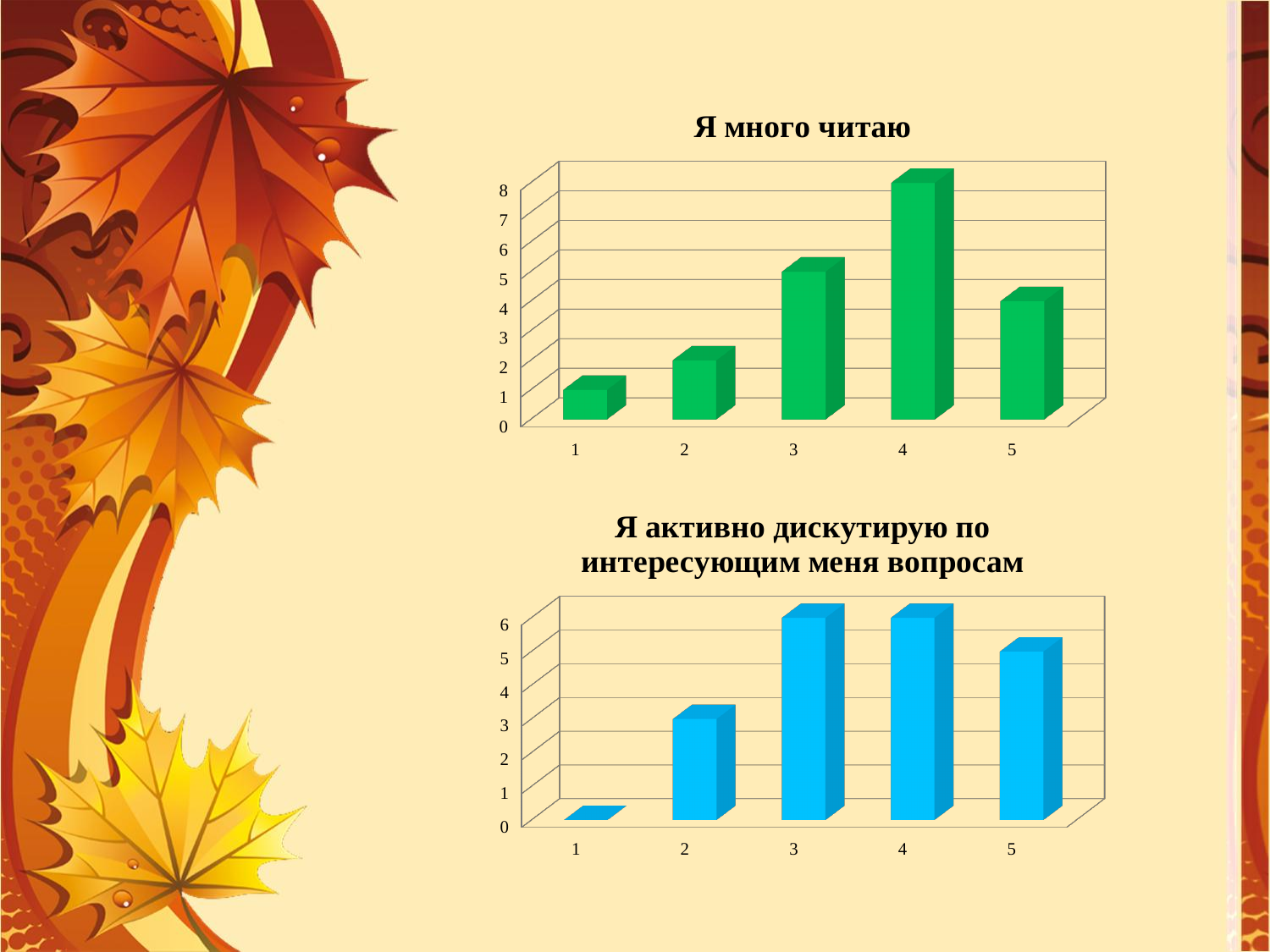
In the chart titled "Я много читаю", is the value for category 3 greater or less than 4? greater In the chart titled "Я много читаю", which is larger, the value for category 3 or the value for category 5? category 3 In the chart titled "Я много читаю", how many categories are shown on the x axis? 5 In the chart titled "Я активно дискутирую по интересующим меня вопросам", which is larger, the value for category 2 or the value for category 5? category 5 What colour are the bars in the bottom chart on the slide? blue In the chart titled "Я активно дискутирую по интересующим меня вопросам", what is the highest value shown on the vertical axis? 6 In the chart titled "Я много читаю", which category has the lowest value? 1 What kind of chart is the top chart on the slide? bar chart In the chart titled "Я активно дискутирую по интересующим меня вопросам", is the value for category 2 greater or less than 4? less In the chart titled "Я много читаю", which category has the highest value? 4 In the chart titled "Я активно дискутирую по интересующим меня вопросам", which category has the lowest value? 1 In the chart titled "Я много читаю", what is the value for category 4? 8